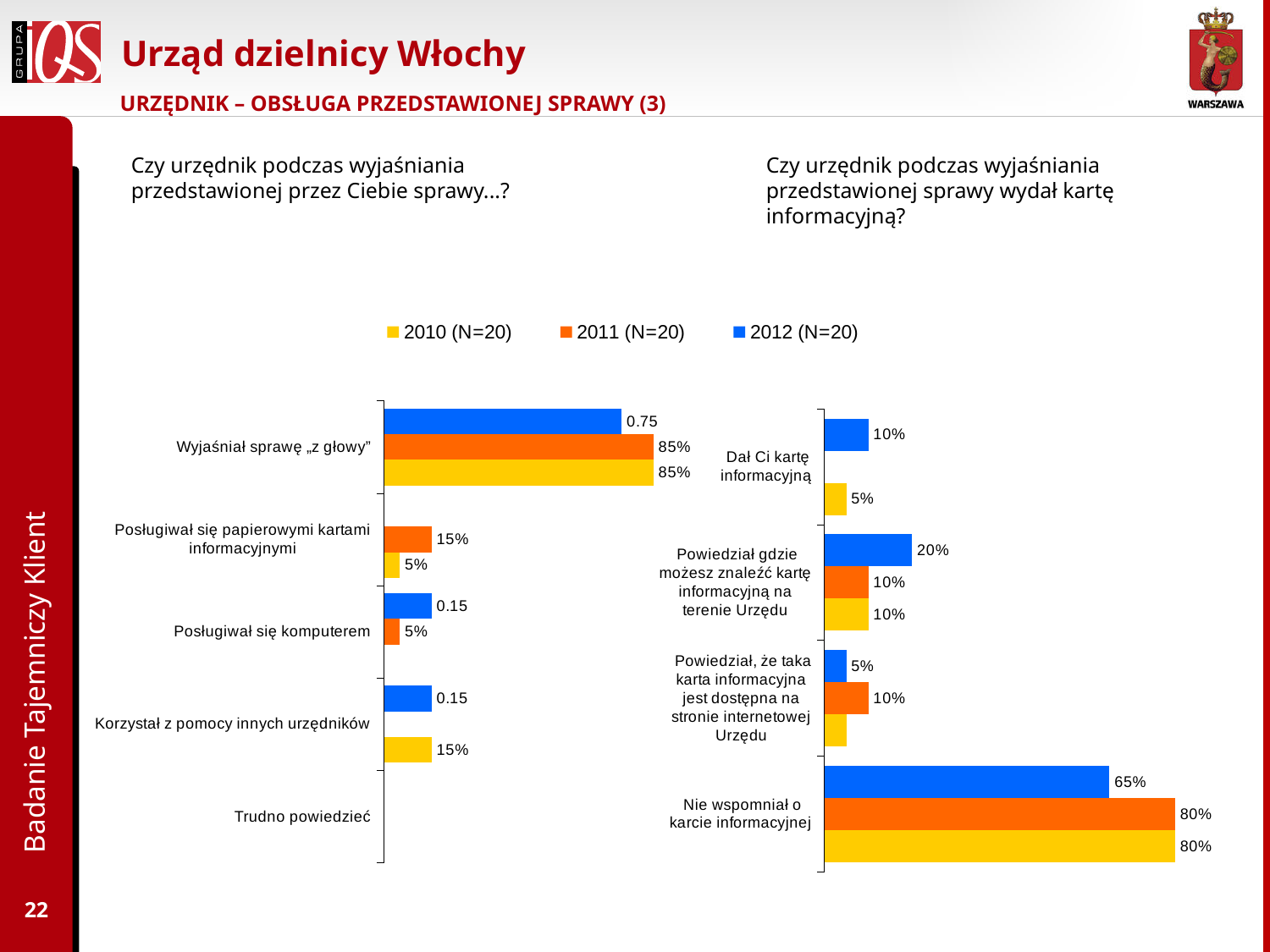
In the left chart (Czy urzędnik podczas wyjaśniania przedstawionej przez Ciebie sprawy...?), what is the value for 'Wyjaśniał sprawę „z głowy"' in 2011 (N=20)? 85% In the left chart (Czy urzędnik podczas wyjaśniania przedstawionej przez Ciebie sprawy...?), what is the value for 'Posługiwał się papierowymi kartami informacyjnymi' in 2010 (N=20)? 5% In the right chart (Czy urzędnik podczas wyjaśniania przedstawionej sprawy wydał kartę informacyjną?), what is the value for 'Nie wspomniał o karcie informacyjnej' in 2012 (N=20)? 65% In the right chart (Czy urzędnik podczas wyjaśniania przedstawionej sprawy wydał kartę informacyjną?), which is larger for 'Nie wspomniał o karcie informacyjnej': the 2011 value or the 2012 value? 2011 In the left chart (Czy urzędnik podczas wyjaśniania przedstawionej przez Ciebie sprawy...?), what is the value for 'Korzystał z pomocy innych urzędników' in 2010 (N=20)? 15% In the right chart (Czy urzędnik podczas wyjaśniania przedstawionej sprawy wydał kartę informacyjną?), what is the difference between the 2011 and 2012 values for 'Nie wspomniał o karcie informacyjnej'? 15% What kind of chart is the right chart (Czy urzędnik podczas wyjaśniania przedstawionej sprawy wydał kartę informacyjną?)? Bar chart In the left chart (Czy urzędnik podczas wyjaśniania przedstawionej przez Ciebie sprawy...?), which category has the highest value for 2012 (N=20)? Wyjaśniał sprawę „z głowy" How many series does the legend list? 3 In the right chart (Czy urzędnik podczas wyjaśniania przedstawionej sprawy wydał kartę informacyjną?), what is the value for 'Powiedział gdzie możesz znaleźć kartę informacyjną na terenie Urzędu' in 2012 (N=20)? 20% In the left chart (Czy urzędnik podczas wyjaśniania przedstawionej przez Ciebie sprawy...?), what is the difference between the 2011 and 2010 values for 'Posługiwał się papierowymi kartami informacyjnymi'? 10% In the right chart (Czy urzędnik podczas wyjaśniania przedstawionej sprawy wydał kartę informacyjną?), what is the value for 'Dał Ci kartę informacyjną' in 2010 (N=20)? 5%